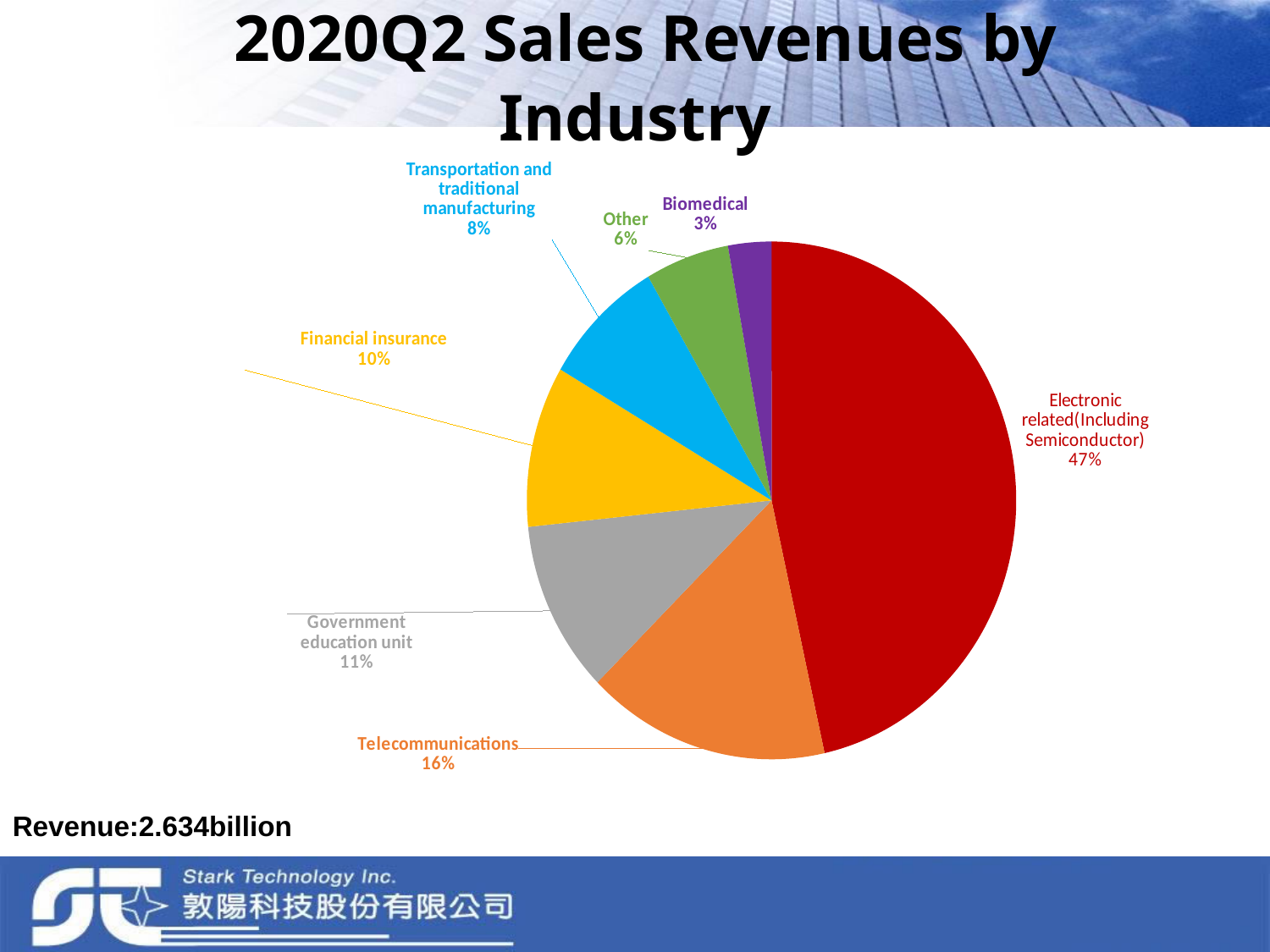
What is the difference in share between Telecommunications and Financial insurance? 6% What share of 2020Q2 sales revenues comes from Financial insurance? 10% What kind of chart is shown on the slide? pie chart What share of 2020Q2 sales revenues comes from Government education unit? 11% What share of 2020Q2 sales revenues comes from Transportation and traditional manufacturing? 8% How many industry slices does the pie chart have? 7 Which has a larger share, Government education unit or Other? Government education unit Which industry has the smallest share of 2020Q2 sales revenues? Biomedical Which industry has the largest share of 2020Q2 sales revenues? Electronic related(Including Semiconductor)